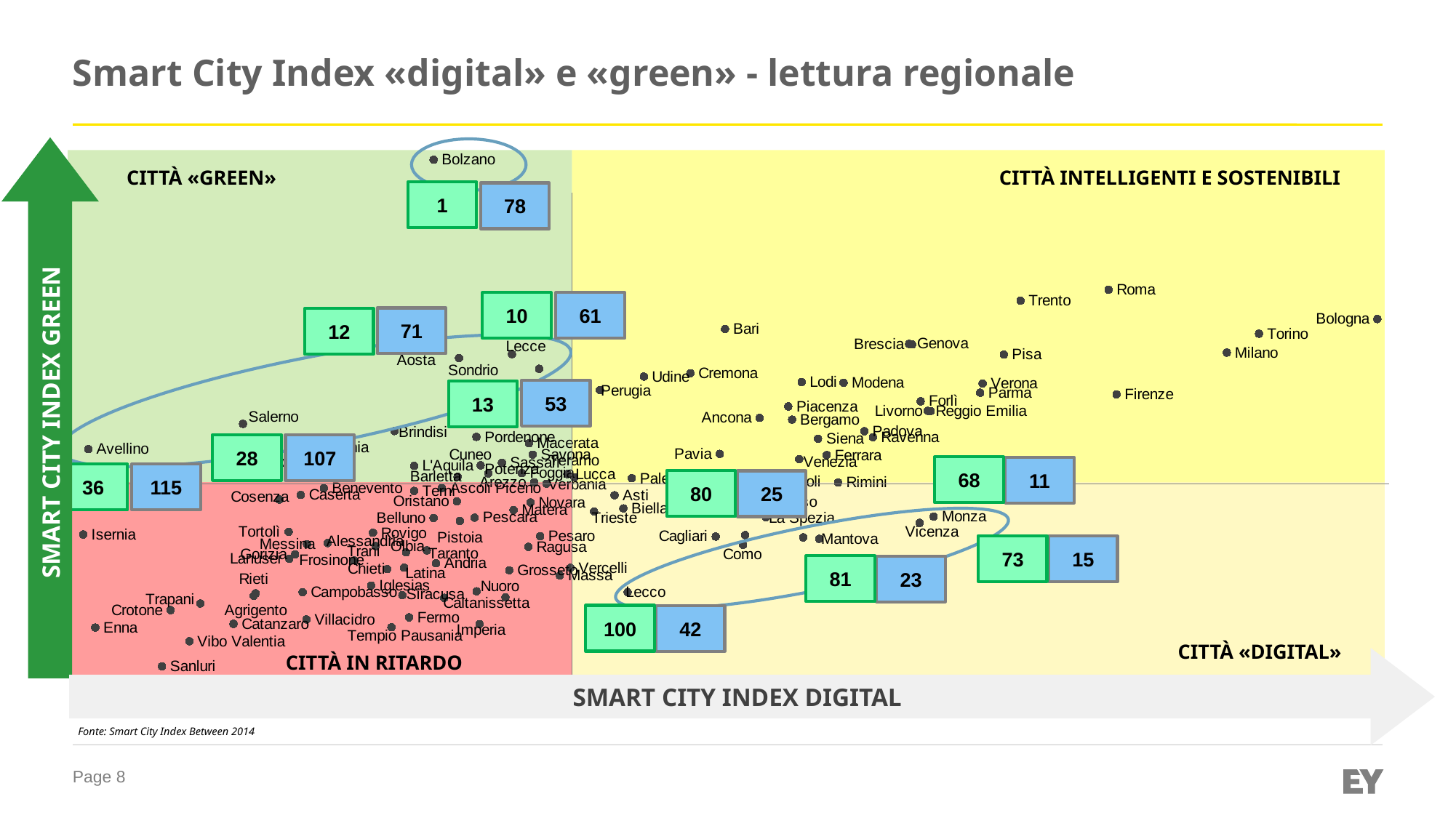
What number is shown in the green box next to Bolzano? 1 Which city has a higher Smart City Index Green value, Bolzano or Sanluri? Bolzano What number is shown in the blue box next to Bolzano? 78 What is the title of the horizontal axis of the chart? SMART CITY INDEX DIGITAL In which quadrant of the chart is Lecco located? CITTÀ «DIGITAL» Which city has the lowest Smart City Index Green value on the chart? Sanluri What is the title of the vertical axis of the chart? SMART CITY INDEX GREEN Which city has the highest Smart City Index Green value on the chart? Bolzano Which city has the highest Smart City Index Digital value on the chart? Bologna What kind of chart is shown on the slide? scatter chart Which city has a higher Smart City Index Digital value, Bologna or Enna? Bologna In which quadrant of the chart is Roma located? CITTÀ INTELLIGENTI E SOSTENIBILI